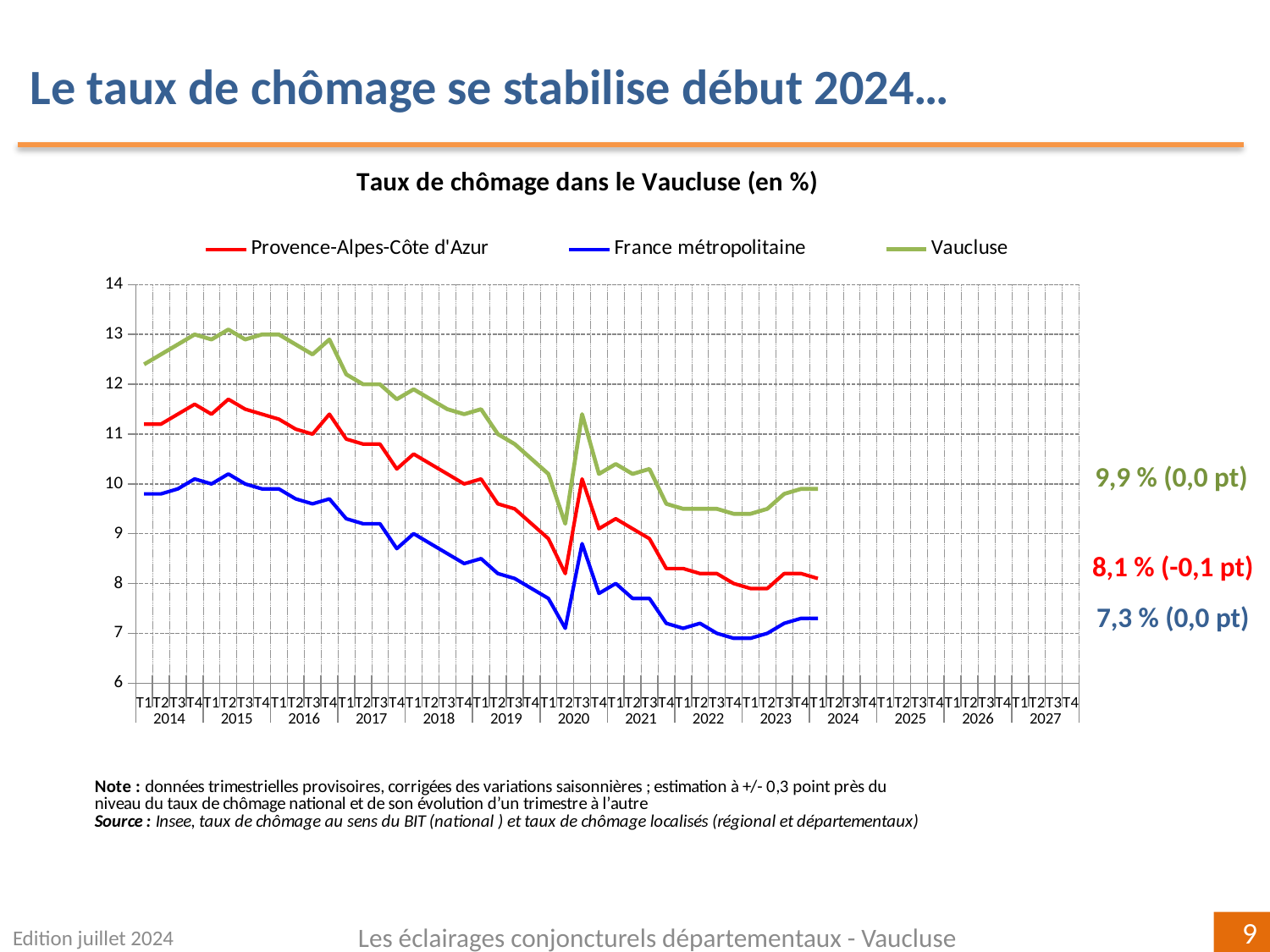
Overall, does the Vaucluse unemployment rate rise or fall between 2014 and 2023? fall What kind of chart is shown on the slide? line chart Which series has the highest value at the end of the period? Vaucluse What is the latest unemployment rate shown for Vaucluse? 9,9 % Which series has the lowest value at the end of the period? France métropolitaine What is the quarterly change shown next to the latest Provence-Alpes-Côte d'Azur value? -0,1 pt What is the latest unemployment rate shown for Provence-Alpes-Côte d'Azur? 8,1 % What is the difference between the latest Vaucluse rate and the latest France métropolitaine rate? 2,6 points What is the title of the chart? Taux de chômage dans le Vaucluse (en %) How many series does the legend list? 3 What is the latest unemployment rate shown for France métropolitaine? 7,3 % Is the Vaucluse unemployment rate in 2015 greater or less than 12? greater